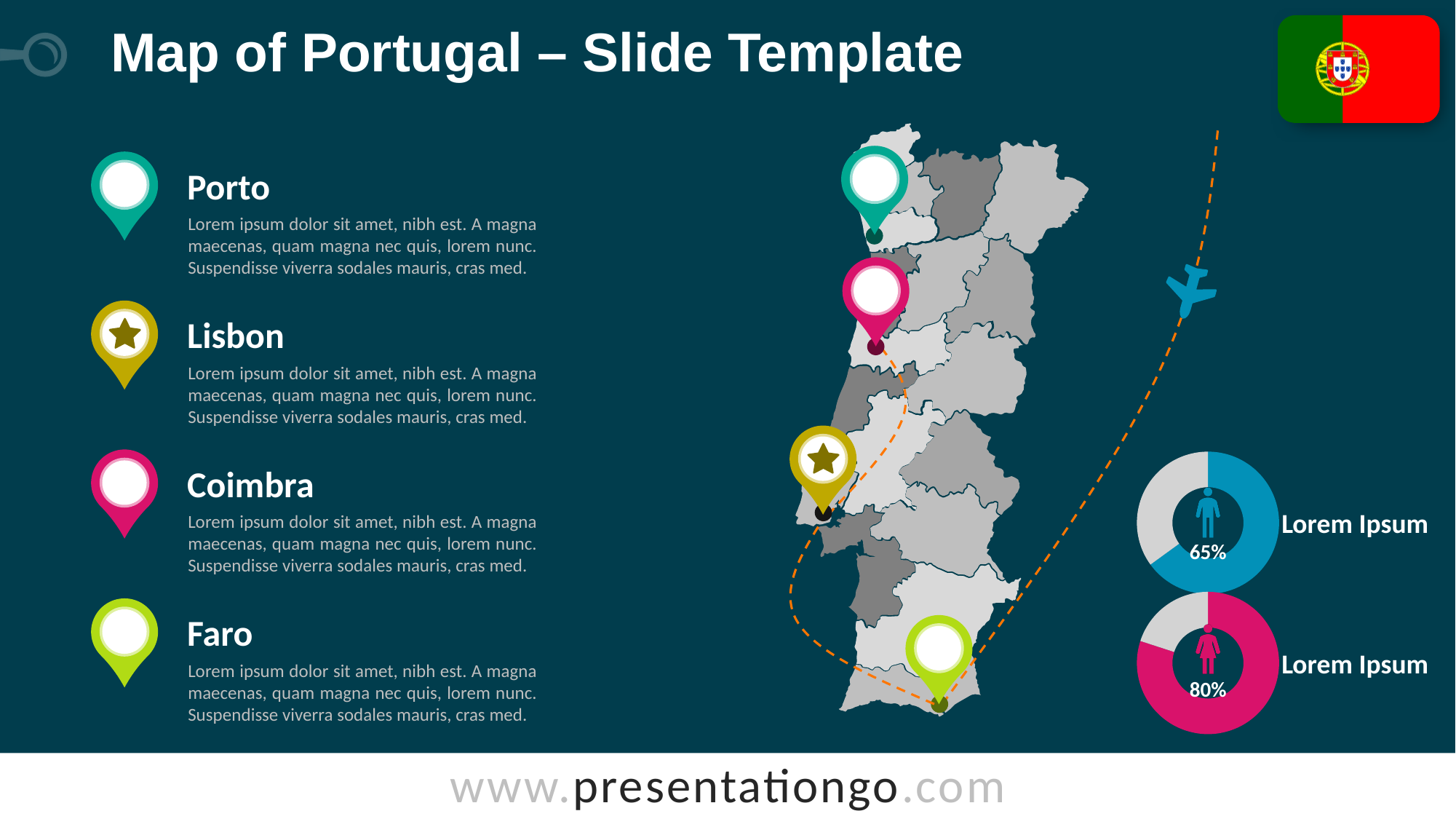
What colour is the filled portion of the donut chart showing 80%? pink What label text appears next to each of the two donut charts? Lorem Ipsum What percentage is shown in the lower pink donut chart on the right of the slide? 80% What percentage is shown in the upper blue donut chart on the right of the slide? 65% Is the value shown in the lower pink donut chart greater or less than 75%? greater What is the difference in percentage points between the lower pink donut chart (80%) and the upper blue donut chart (65%)? 15 percentage points What kind of charts are the two circular charts on the right side of the slide? donut (pie) charts Which donut chart shows the larger percentage, the upper blue one or the lower pink one? the lower pink one Is the value shown in the upper blue donut chart greater or less than 50%? greater How many donut charts are shown on the right side of the slide? 2